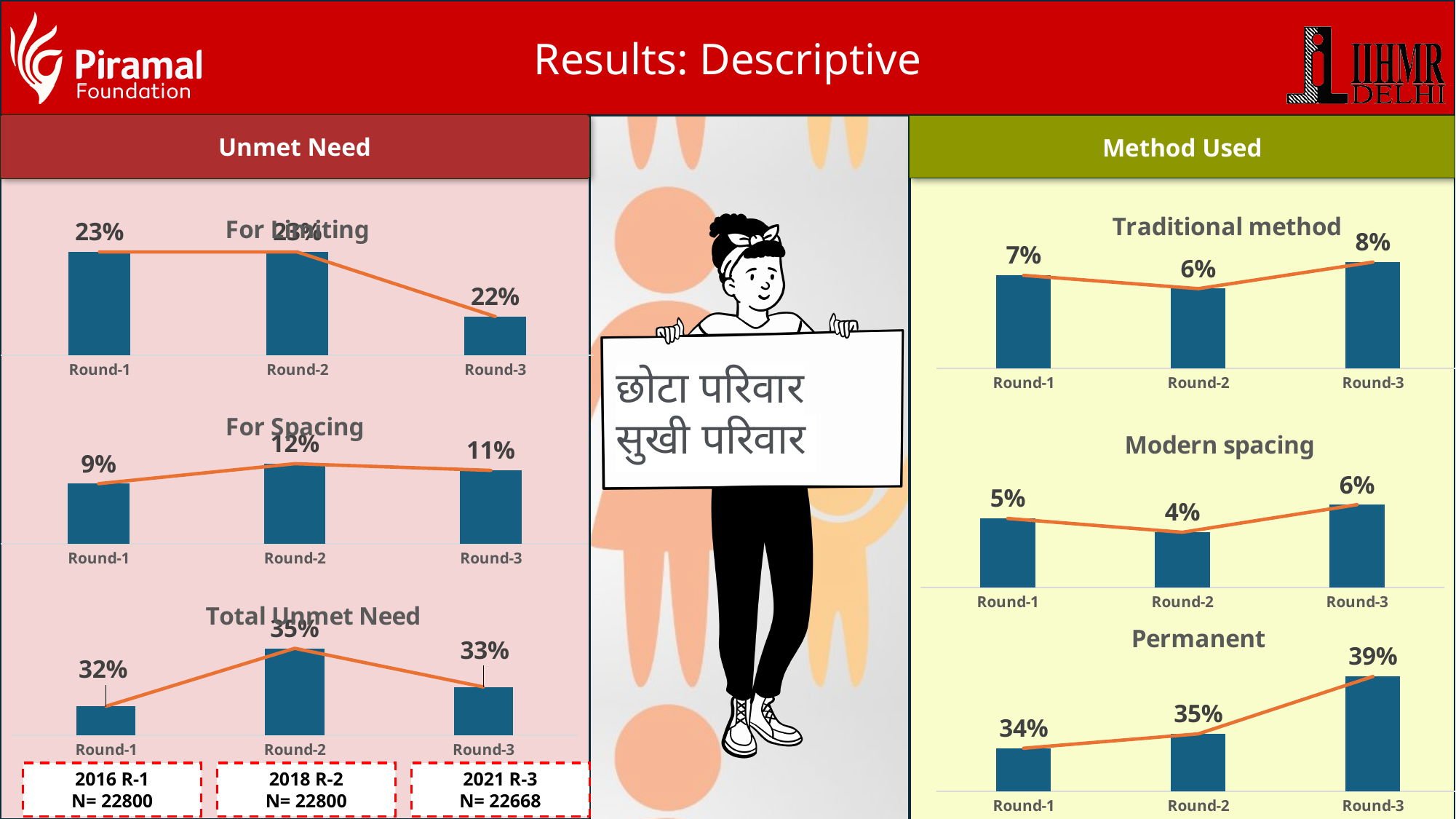
In the "Traditional method" chart, which round has the highest value? Round-3 In the "Permanent" chart, what is the difference between the Round-3 and Round-1 values? 5% In the "For Spacing" chart, what is the value for Round-2? 12% In the "For Limiting" chart, what is the value for Round-3? 22% What kind of chart is the "Permanent" chart? Bar chart with a line overlay In the "Permanent" chart, do the values rise or fall from Round-1 to Round-3? Rise How many rounds are shown on the x axis of the "Modern spacing" chart? 3 In the "Permanent" chart, what is the value for Round-1? 34% In the "Total Unmet Need" chart, what is the value for Round-3? 33% In the "Total Unmet Need" chart, which is larger, the value for Round-2 or Round-1? Round-2 In the "Modern spacing" chart, which round has the lowest value? Round-2 In the "For Spacing" chart, what is the difference between the Round-2 and Round-1 values? 3%